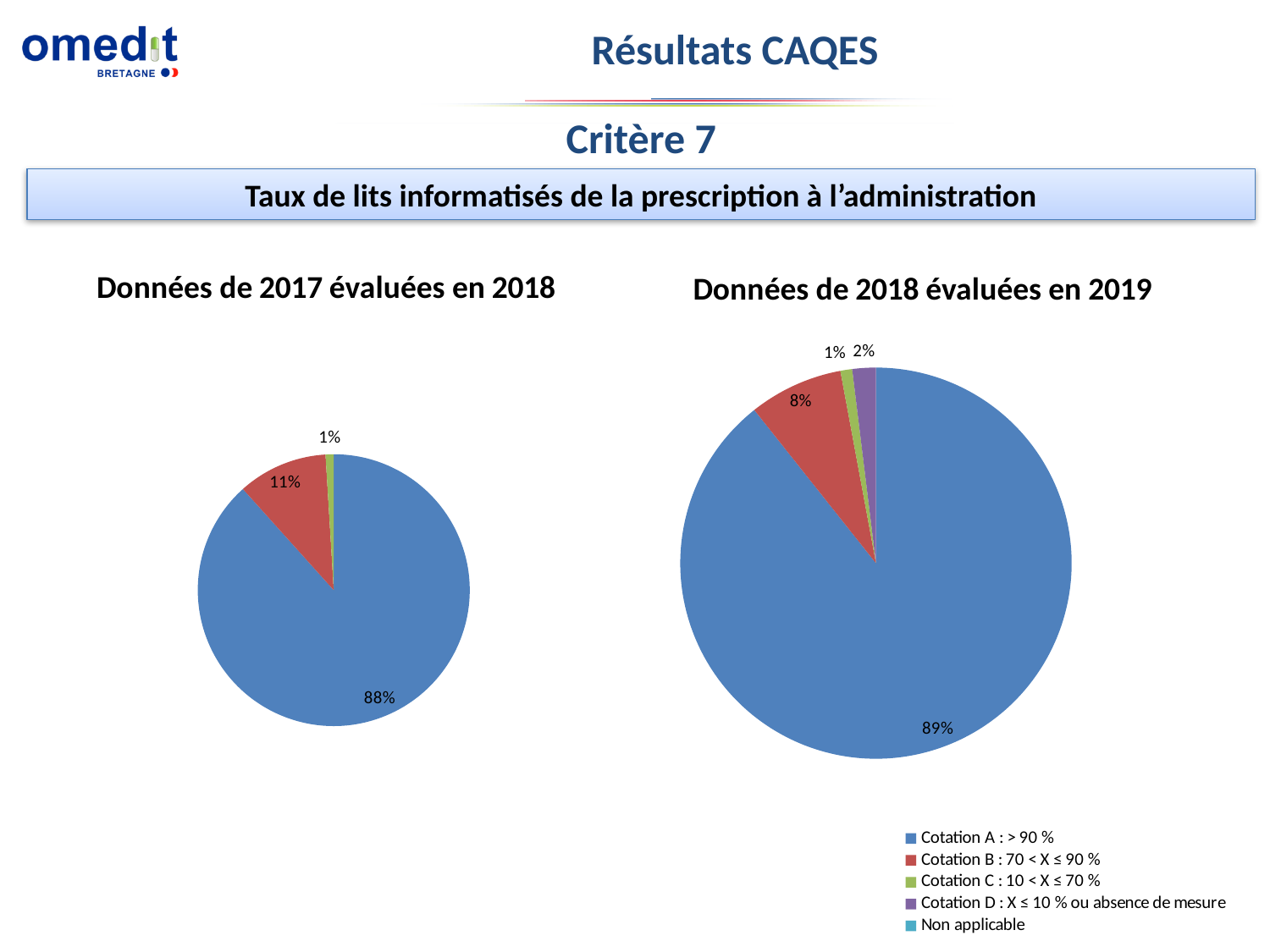
In the chart 'Données de 2018 évaluées en 2019', what is the difference between the Cotation A share and the Cotation B share? 81 percentage points In the chart 'Données de 2018 évaluées en 2019', which category has the largest slice? Cotation A : > 90 % Which chart shows a larger share for Cotation A : > 90 %, 'Données de 2017 évaluées en 2018' or 'Données de 2018 évaluées en 2019'? Données de 2018 évaluées en 2019 In the chart 'Données de 2018 évaluées en 2019', what share of the pie is Cotation B : 70 < X ≤ 90 %? 8% How many slices does the chart 'Données de 2018 évaluées en 2019' have? 4 In the chart 'Données de 2018 évaluées en 2019', what share of the pie is Cotation D : X ≤ 10 % ou absence de mesure? 2% In the chart 'Données de 2017 évaluées en 2018', which category has the smallest slice? Cotation C : 10 < X ≤ 70 % In the chart 'Données de 2017 évaluées en 2018', what share of the pie is Cotation B : 70 < X ≤ 90 %? 11% How many entries does the legend on the slide list? 5 How many slices does the chart 'Données de 2017 évaluées en 2018' have? 3 In the chart 'Données de 2017 évaluées en 2018', what share of the pie is Cotation A : > 90 %? 88% What type of chart is 'Données de 2017 évaluées en 2018'? Pie chart